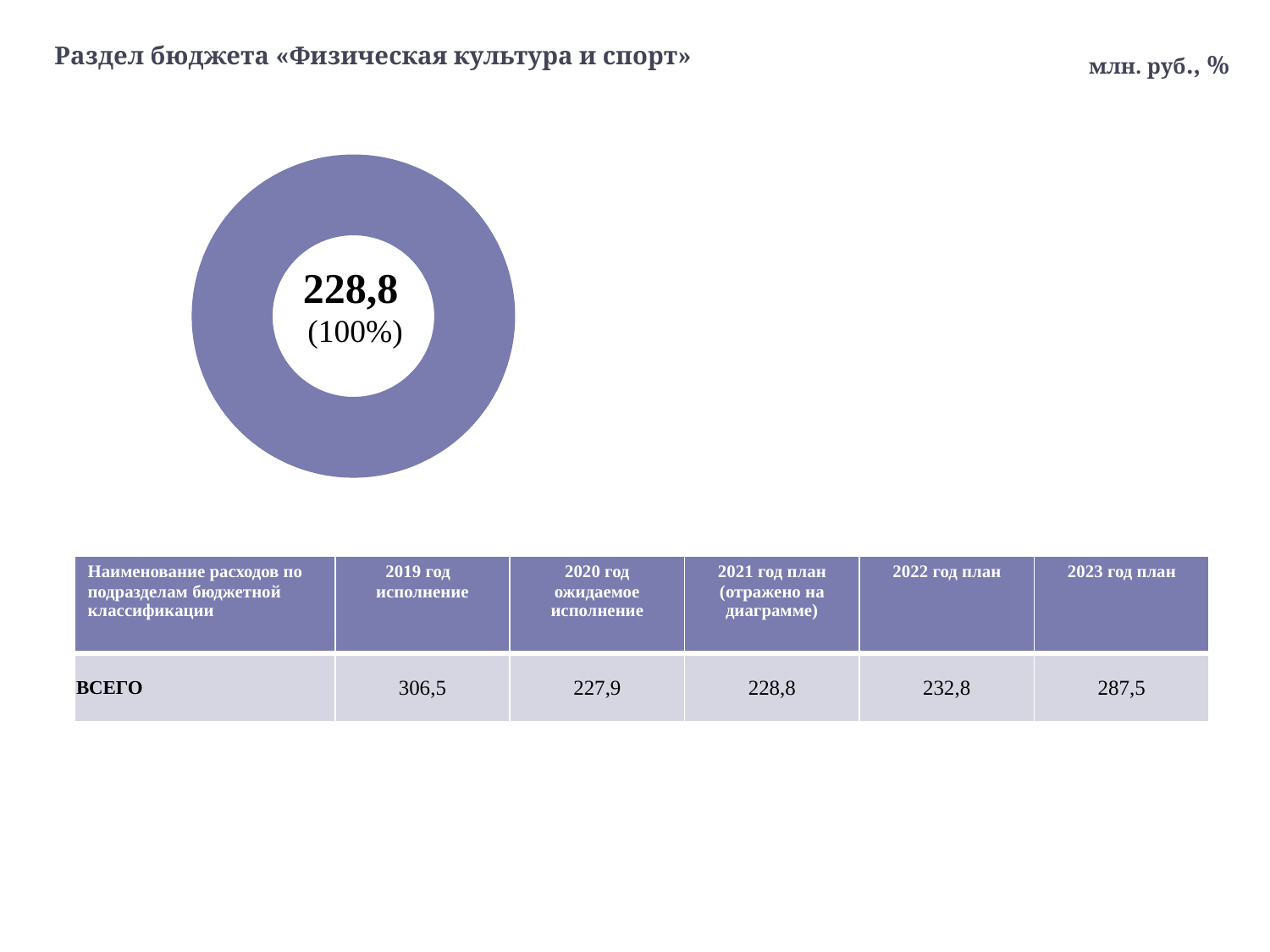
What kind of chart is shown on the slide? doughnut (pie) chart How many slices does the doughnut chart have? 1 What value is printed in the centre of the doughnut chart? 228,8 According to the table, which year's figure is reflected in the doughnut chart? 2021 год план What is the total value represented by the doughnut chart? 228,8 What share of the doughnut chart does the single slice represent? 100% What colour is the ring of the doughnut chart? purple (blue-violet) What units are indicated in the top right corner of the slide for the chart values? млн. руб., %